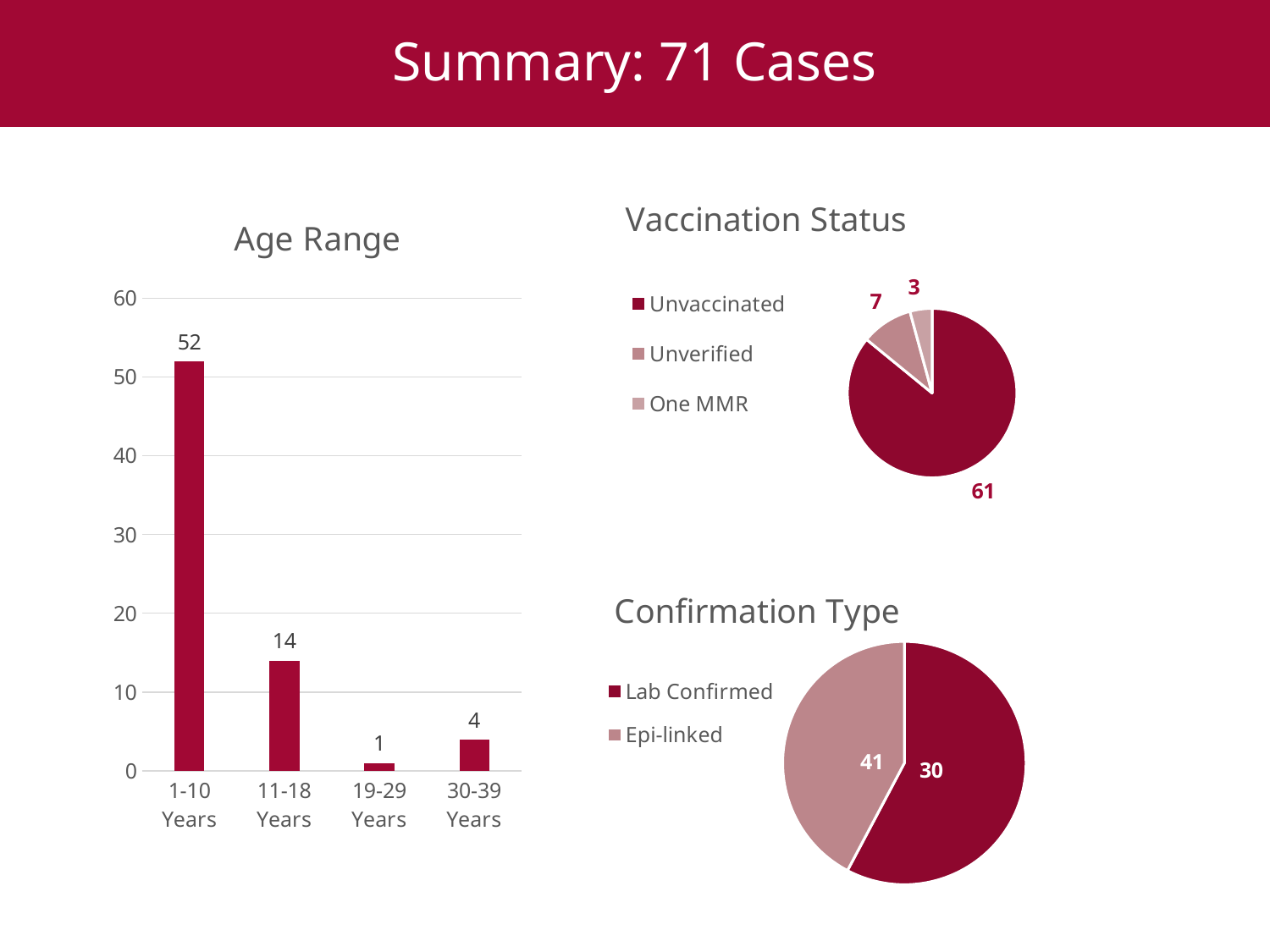
In the Confirmation Type chart, how many cases are Epi-linked? 30 In the Age Range chart, which is larger: the value for 11-18 Years or 30-39 Years? 11-18 Years In the Age Range chart, which age range has the fewest cases? 19-29 Years How many categories does the legend of the Vaccination Status chart list? 3 In the Age Range chart, how many cases are in the 1-10 Years category? 52 In the Age Range chart, what is the difference between the 1-10 Years and 11-18 Years values? 38 What type of chart is the Age Range chart? bar chart In the Vaccination Status chart, how many cases are labelled One MMR? 3 In the Confirmation Type chart, what is the difference between the Epi-linked and Lab Confirmed values? 11 In the Age Range chart, which age range has the most cases? 1-10 Years In the Vaccination Status chart, how many cases are Unvaccinated? 61 How many age range categories are shown in the Age Range chart? 4